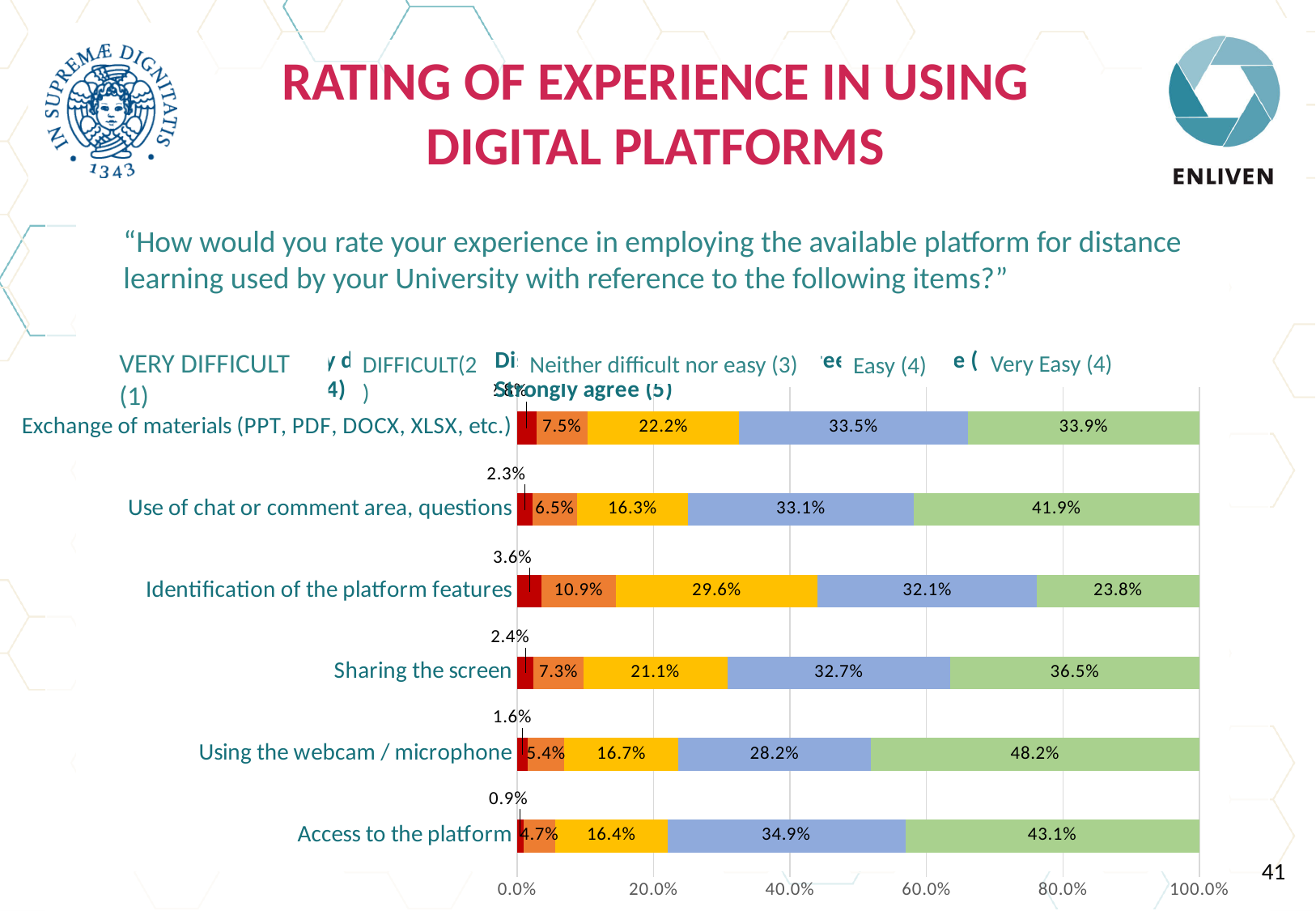
What type of chart is shown on the slide? Stacked horizontal bar chart Which item has the highest DIFFICULT (2) percentage? Identification of the platform features Which has a larger Easy (4) value: 'Exchange of materials (PPT, PDF, DOCX, XLSX, etc.)' or 'Access to the platform'? Access to the platform How many items (categories) are plotted in the chart? 6 What percentage of respondents rated 'Using the webcam / microphone' as Very Easy? 48.2% What is the 'Neither difficult nor easy (3)' value for 'Identification of the platform features'? 29.6% What is the difference between the Very Easy values for 'Use of chat or comment area, questions' and 'Sharing the screen'? 5.4 percentage points What is the Easy (4) value for 'Access to the platform'? 34.9% What is the VERY DIFFICULT (1) value for 'Access to the platform'? 0.9% Which item has the highest Very Easy percentage? Using the webcam / microphone What is the DIFFICULT (2) value for 'Identification of the platform features'? 10.9% Which item has the lowest Very Easy percentage? Identification of the platform features